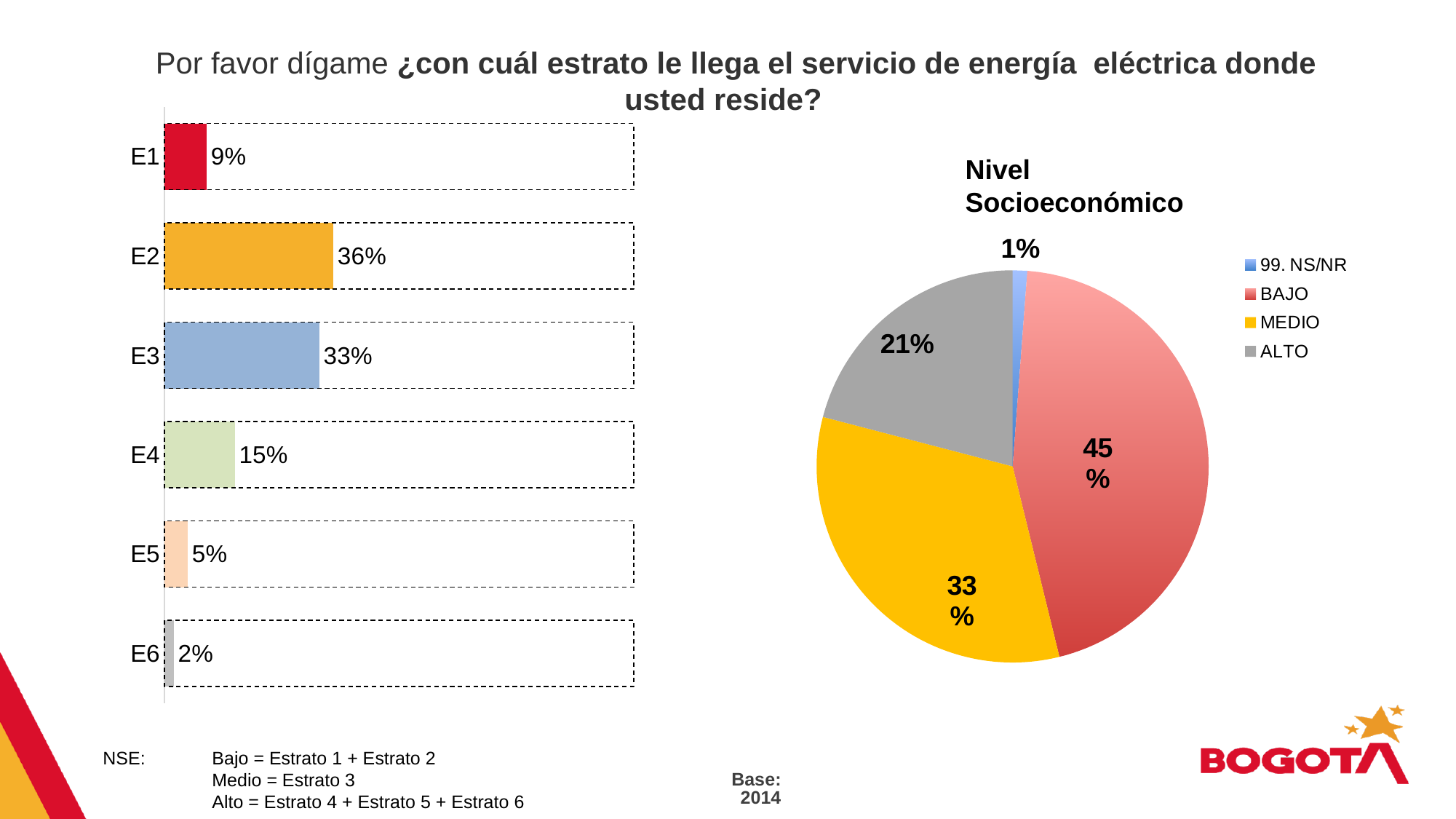
In the bar chart on the left, what is the value for E5? 5% In the bar chart on the left, which category has the highest value? E2 In the pie chart titled 'Nivel Socioeconómico', what is the share for BAJO? 45% In the bar chart on the left, which is larger, the value for E1 or the value for E4? E4 In the bar chart on the left, what is the value for E2? 36% How many entries does the legend of the pie chart titled 'Nivel Socioeconómico' list? 4 In the bar chart on the left, which category has the lowest value? E6 In the bar chart on the left, what is the difference between the values for E2 and E3? 3% In the pie chart titled 'Nivel Socioeconómico', which slice is the smallest? 99. NS/NR How many categories does the bar chart on the left show? 6 What kind of chart is the chart on the left? Bar chart In the pie chart titled 'Nivel Socioeconómico', what is the share for ALTO? 21%